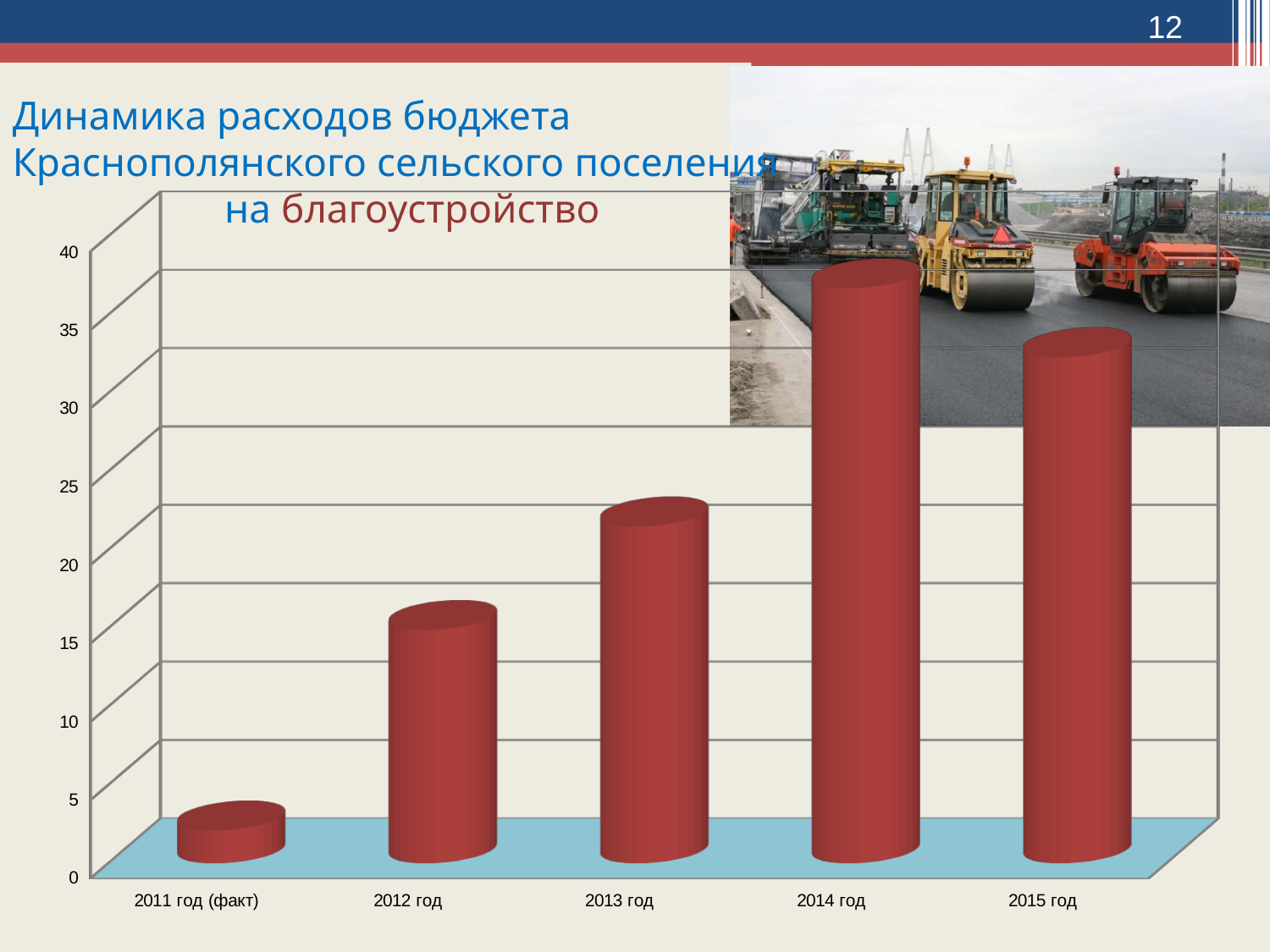
Is the value for 2014 год greater or less than 35? greater How many categories (years) are shown on the x axis of the chart? 5 Which is larger, the value for 2014 год or the value for 2015 год? 2014 год Is the value for 2012 год greater or less than 20? less What kind of chart is shown on the slide? bar chart Which is larger, the value for 2012 год or the value for 2013 год? 2013 год Is the value for 2011 год (факт) greater or less than 5? less Which year has the highest value in the chart? 2014 год What is the highest tick value shown on the vertical axis of the chart? 40 How do the values change from 2011 год (факт) to 2014 год? they rise Which year has the lowest value in the chart? 2011 год (факт)